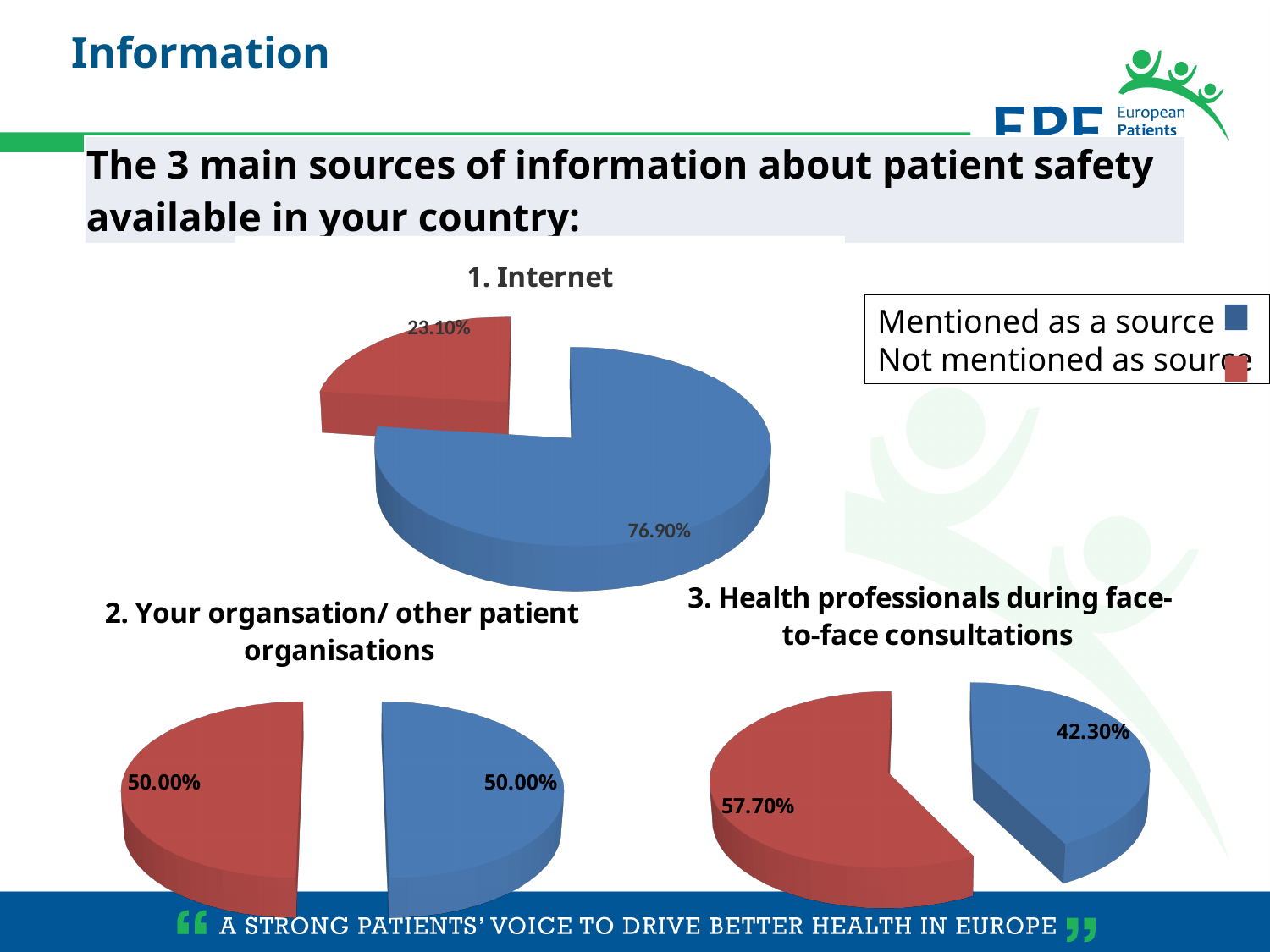
In the '2. Your organsation/ other patient organisations' chart, what percentage is shown for 'Mentioned as a source'? 50.00% In the '3. Health professionals during face-to-face consultations' chart, what percentage is shown for 'Mentioned as a source'? 42.30% Which is larger: the 'Mentioned as a source' share in the '1. Internet' chart or the 'Mentioned as a source' share in the '3. Health professionals during face-to-face consultations' chart? 1. Internet How many entries does the legend list? 2 In the '3. Health professionals during face-to-face consultations' chart, what percentage is shown for 'Not mentioned as source'? 57.70% In the '3. Health professionals during face-to-face consultations' chart, what is the difference between the 'Not mentioned as source' and 'Mentioned as a source' percentages? 15.40% What type of chart is used for '1. Internet'? Pie chart In the '3. Health professionals during face-to-face consultations' chart, which slice is the smallest? Mentioned as a source In the '1. Internet' chart, what percentage is shown for 'Not mentioned as source'? 23.10% In the '1. Internet' chart, which slice is the largest? Mentioned as a source In the '1. Internet' chart, what percentage is shown for 'Mentioned as a source'? 76.90% In the '1. Internet' chart, what is the difference between the 'Mentioned as a source' and 'Not mentioned as source' percentages? 53.80%